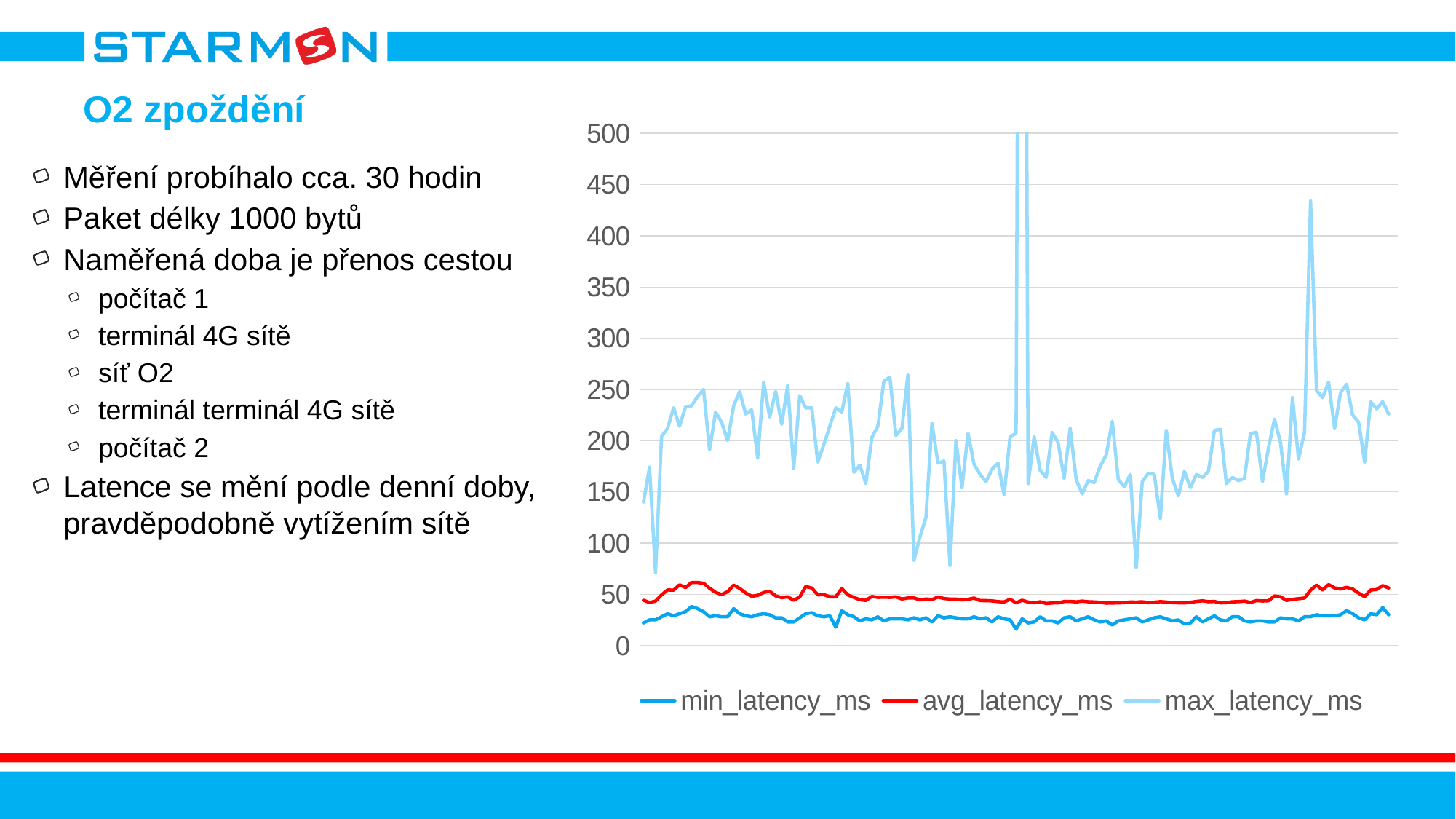
Are the values of avg_latency_ms greater or less than 100 throughout the chart? less Which series in the chart has the lowest values throughout? min_latency_ms How many series does the chart legend list? 3 What is the maximum value shown on the chart's vertical axis? 500 What colour is the avg_latency_ms line in the chart? red Is the highest spike of max_latency_ms greater or less than 450? greater Which series is plotted in light blue? max_latency_ms Are the values of min_latency_ms greater or less than 50 throughout the chart? less Which series in the chart has the highest values throughout? max_latency_ms What kind of chart is shown on the slide? line chart Which series is larger, avg_latency_ms or min_latency_ms? avg_latency_ms